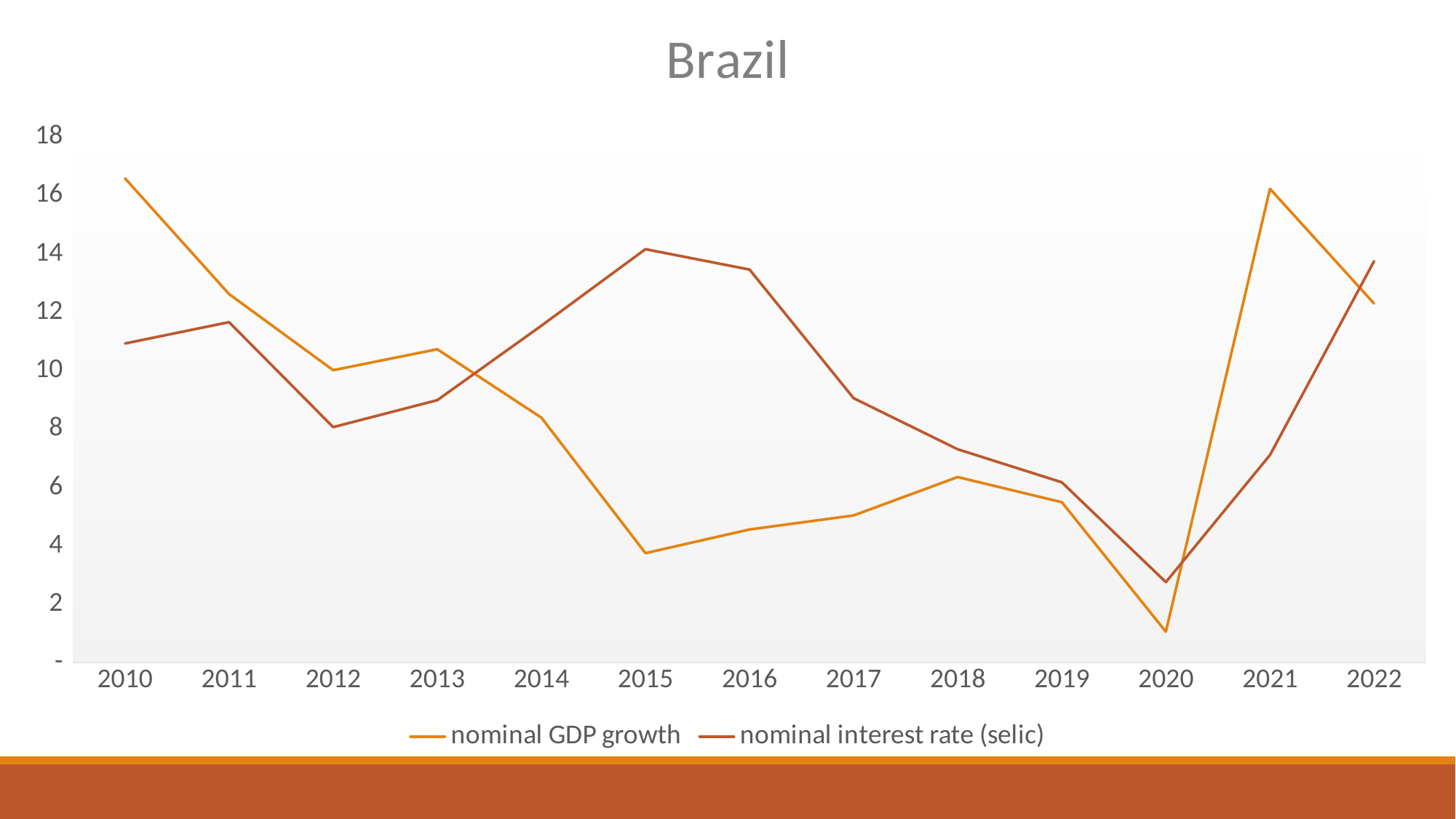
Is the value for nominal GDP growth in 2015 greater or less than 4? less What kind of chart is shown on the slide? line chart In 2021, which is larger: nominal GDP growth or the nominal interest rate (selic)? nominal GDP growth Does nominal GDP growth rise or fall from 2010 to 2015? fall How many years are shown on the x axis? 13 Is the value for nominal interest rate (selic) in 2016 greater or less than 12? greater In which year is nominal GDP growth lowest? 2020 How many series does the legend list? 2 In which year is the nominal interest rate (selic) lowest? 2020 Is the value for nominal GDP growth in 2010 greater or less than 16? greater In 2015, which is larger: nominal GDP growth or the nominal interest rate (selic)? nominal interest rate (selic) What is the title of the chart? Brazil